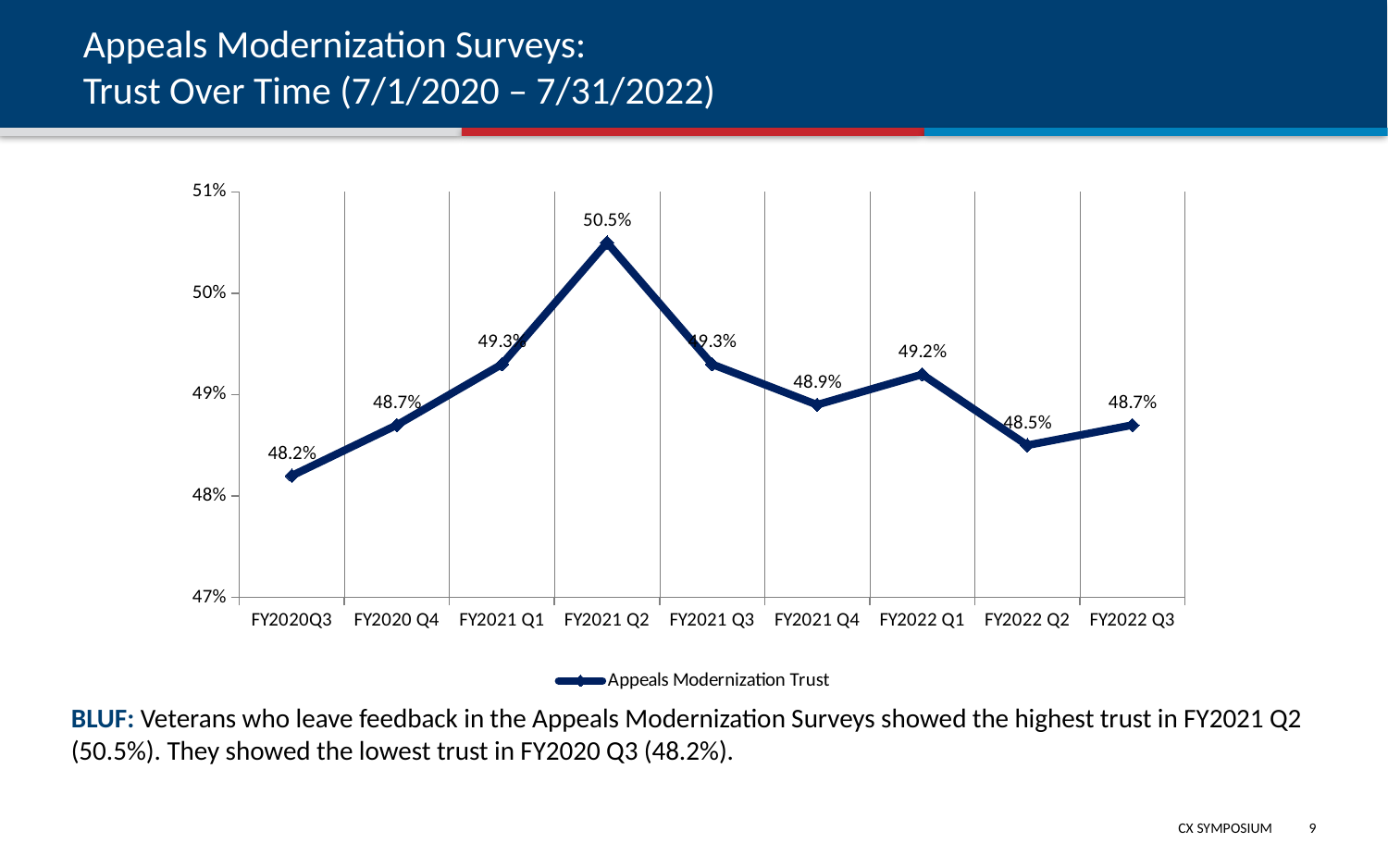
What kind of chart is shown on the slide? line chart What is the Appeals Modernization Trust value for FY2021 Q2? 50.5% Is the trust value for FY2021 Q2 greater or less than 50%? greater Which quarter has the highest Appeals Modernization Trust value? FY2021 Q2 What is the difference between the trust values for FY2021 Q2 and FY2020Q3? 2.3% What is the Appeals Modernization Trust value for FY2021 Q4? 48.9% How many quarters are plotted on the chart? 9 Which is larger, the trust value for FY2022 Q1 or for FY2022 Q2? FY2022 Q1 What is the Appeals Modernization Trust value for FY2020Q3? 48.2% Which quarter has the lowest Appeals Modernization Trust value? FY2020Q3 What series name does the legend show? Appeals Modernization Trust What is the Appeals Modernization Trust value for FY2022 Q2? 48.5%